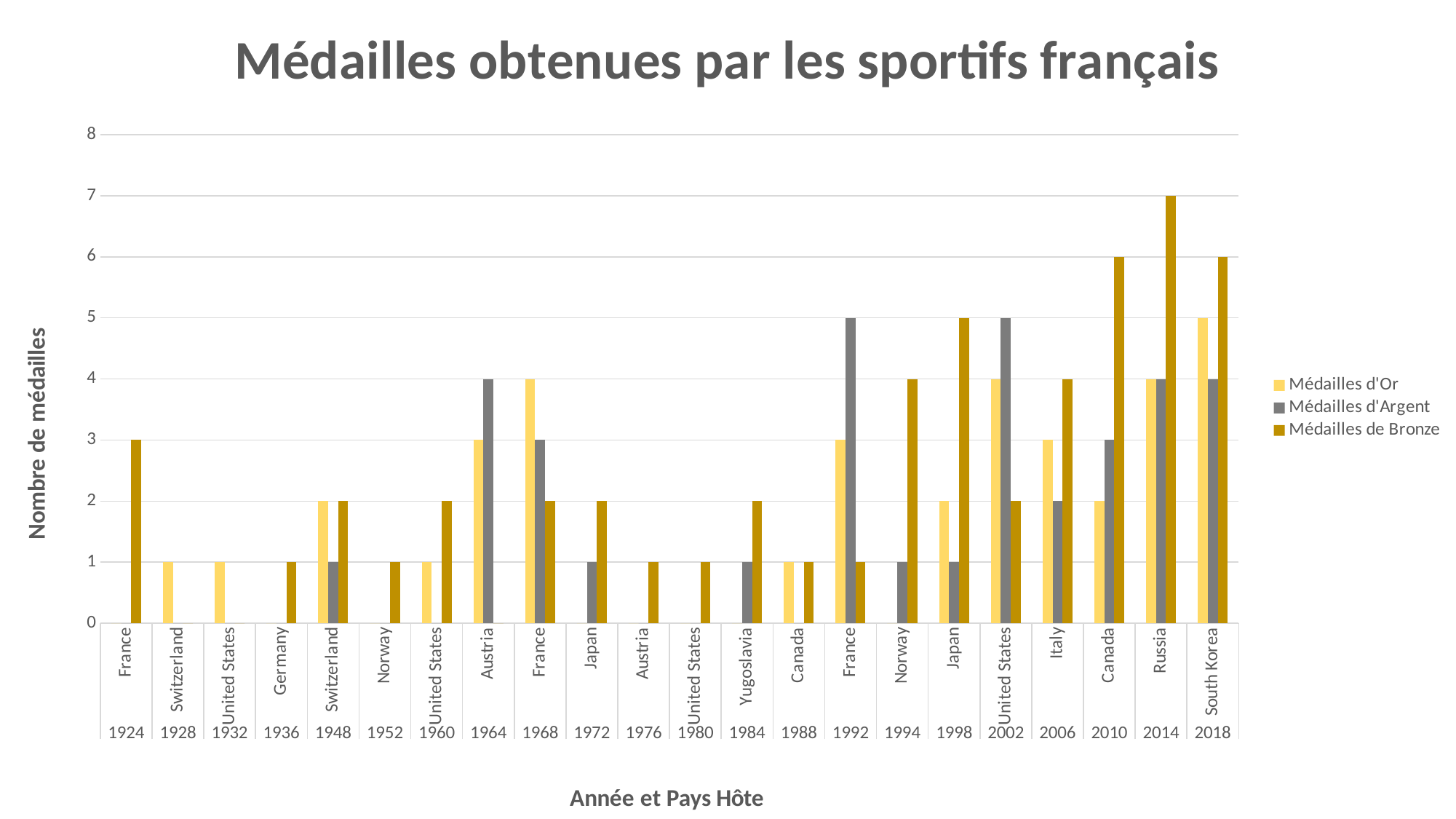
What is the title of the chart? Médailles obtenues par les sportifs français How many Médailles de Bronze were won in 2014 (Russia)? 7 How many series does the legend list? 3 What kind of chart is shown on the slide? bar chart How many Médailles d'Or were won in 2018 (South Korea)? 5 What is the difference between Médailles de Bronze and Médailles d'Or in 2010 (Canada)? 4 In which year is the Médailles de Bronze bar the highest? 2014 How many year/host-country categories are shown on the x axis? 22 How many Médailles d'Argent were won in 1992 (France)? 5 Is the value for Médailles de Bronze in 2018 (South Korea) greater or less than 5? greater What is the label of the vertical axis? Nombre de médailles In 1968 (France), which is larger: Médailles d'Or or Médailles d'Argent? Médailles d'Or